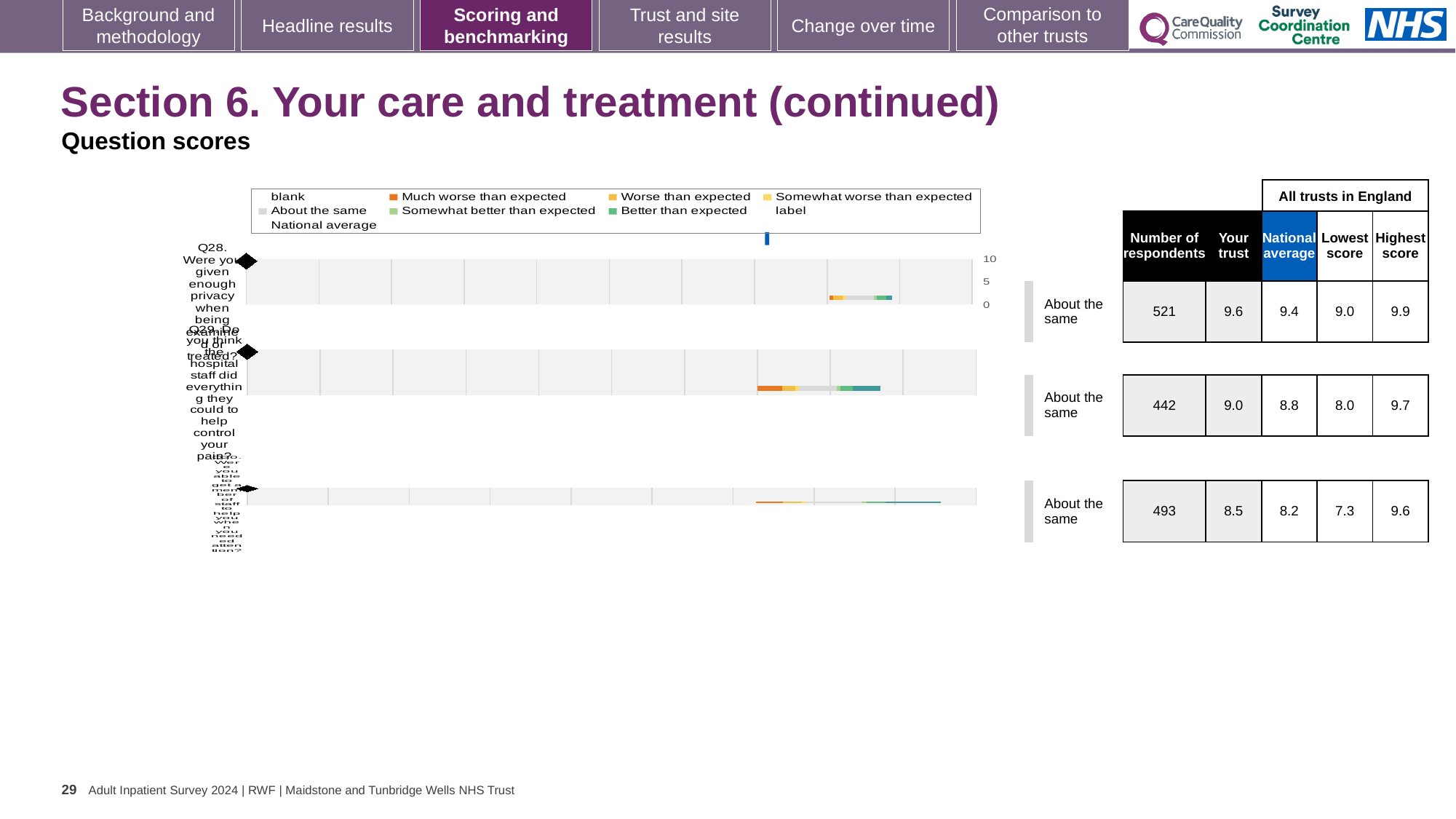
What is the highest score among all trusts in England for Q30? 9.6 Which legend entry is represented by the orange colour? Much worse than expected What is the difference between the 'Your trust' score and the national average for Q28? 0.2 Which question has the lowest national average score? Q30 What kind of chart is shown on the slide? bar chart What is the 'Your trust' score for Q28 (Were you given enough privacy when being examined or treated?)? 9.6 Which question has the highest 'Your trust' score? Q28 What is the national average score for Q29 (Do you think the hospital staff did everything they could to help control your pain?)? 8.8 What benchmark category is shown for Q29? About the same How many questions (rows) are plotted in the chart? 3 Which has the larger 'Your trust' score, Q29 or Q30? Q29 How many respondents answered Q30? 493